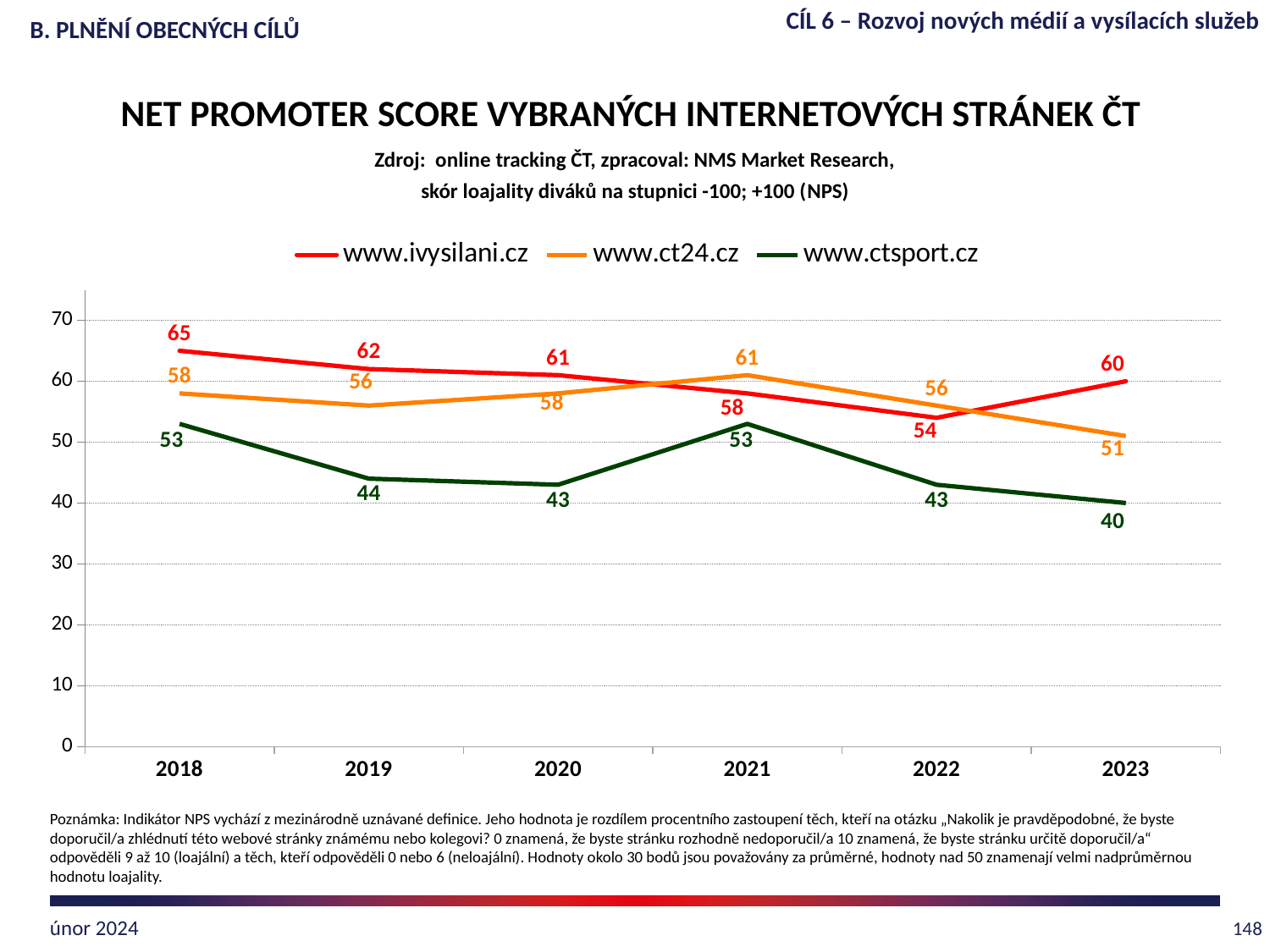
Does the value for www.ct24.cz rise or fall from 2021 to 2023? fall Which series is drawn in green? www.ctsport.cz In which year does www.ivysilani.cz have its highest value? 2018 Which is larger in 2022: the value for www.ct24.cz or the value for www.ivysilani.cz? www.ct24.cz What is the difference between the www.ivysilani.cz value in 2018 and its value in 2022? 11 In which year does www.ctsport.cz have its lowest value? 2023 What kind of chart is shown on the slide? line chart What is the NPS value for www.ct24.cz in 2021? 61 How many years are shown on the x axis? 6 What is the NPS value for www.ivysilani.cz in 2018? 65 How many series does the legend list? 3 What is the NPS value for www.ctsport.cz in 2023? 40